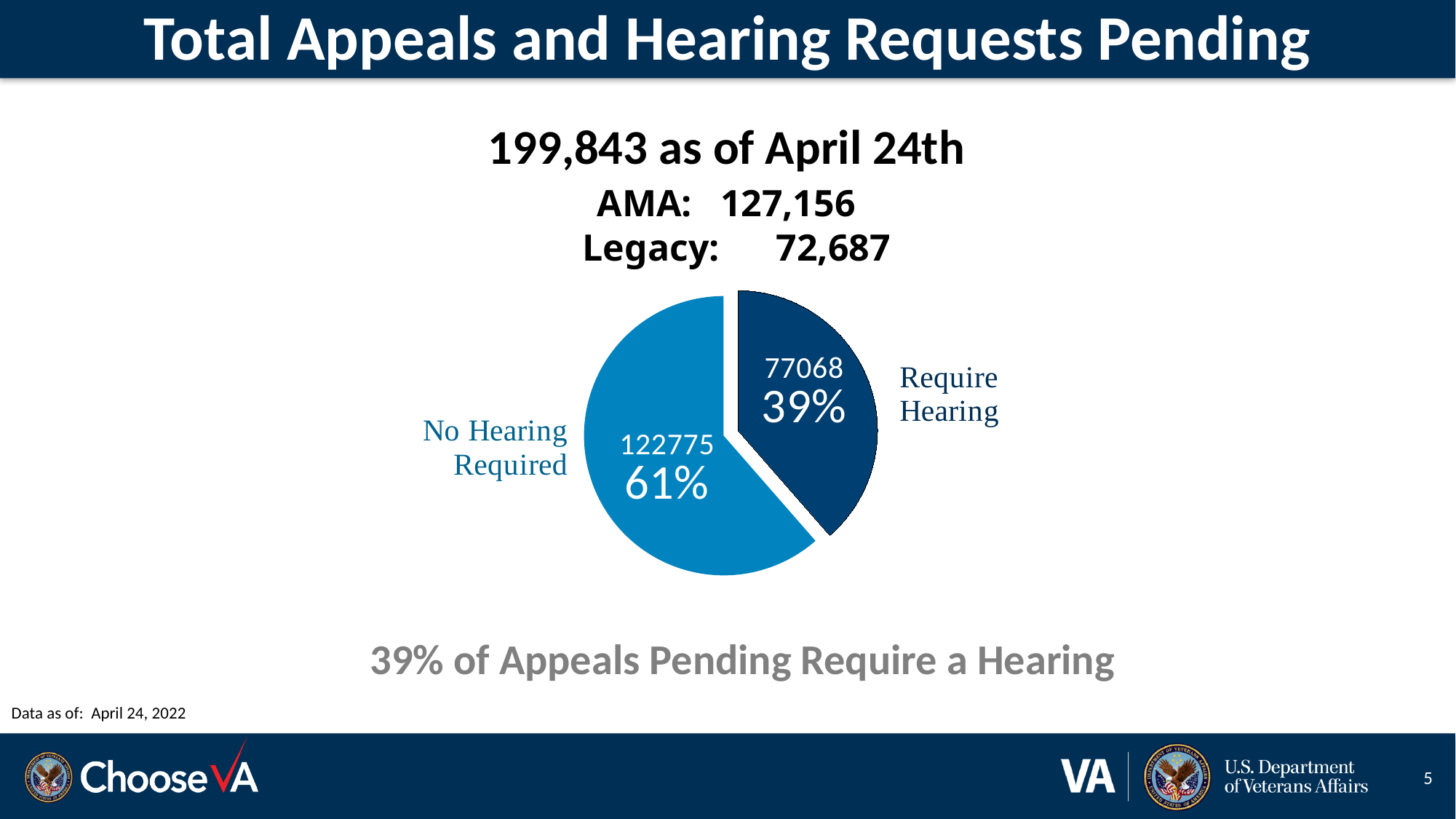
What is the total of the two slices in the pie chart? 199843 What share of the pie does the No Hearing Required slice represent? 61% What is the value for the Require Hearing slice? 77068 What share of the pie does the Require Hearing slice represent? 39% What is the difference between the No Hearing Required value and the Require Hearing value? 45707 How many slices does the pie chart have? 2 Which is larger, the Require Hearing slice or the No Hearing Required slice? No Hearing Required What colour is the Require Hearing slice? dark blue Which slice is the smallest? Require Hearing Which slice is the largest? No Hearing Required What is the value for the No Hearing Required slice? 122775 What kind of chart is shown on the slide? pie chart